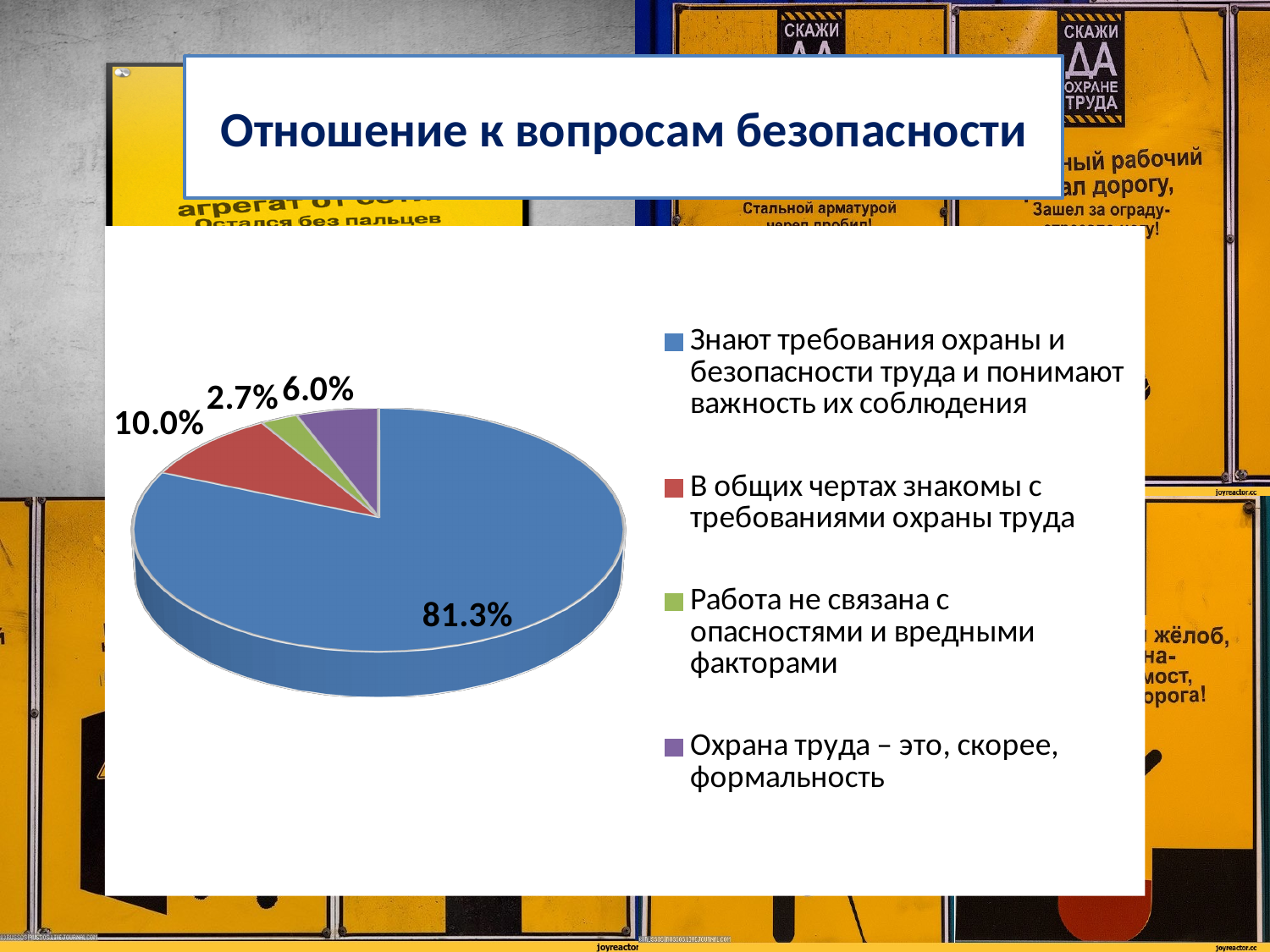
How many slices does the pie chart have? 4 What kind of chart is shown on the slide? Pie chart What is the difference in percentage points between the 81.3% slice and the 10.0% slice? 71.3 What share of the pie is labelled for "Знают требования охраны и безопасности труда и понимают важность их соблюдения"? 81.3% Which is larger: the slice for "Охрана труда – это, скорее, формальность" or the slice for "В общих чертах знакомы с требованиями охраны труда"? В общих чертах знакомы с требованиями охраны труда Which category has the largest slice of the pie? Знают требования охраны и безопасности труда и понимают важность их соблюдения What is the title of the chart on the slide? Отношение к вопросам безопасности What share of the pie is labelled for "Охрана труда – это, скорее, формальность"? 6.0% Which category has the smallest slice of the pie? Работа не связана с опасностями и вредными факторами What share of the pie is labelled for "Работа не связана с опасностями и вредными факторами"? 2.7% What share of the pie is labelled for "В общих чертах знакомы с требованиями охраны труда"? 10.0% How many entries does the legend list? 4